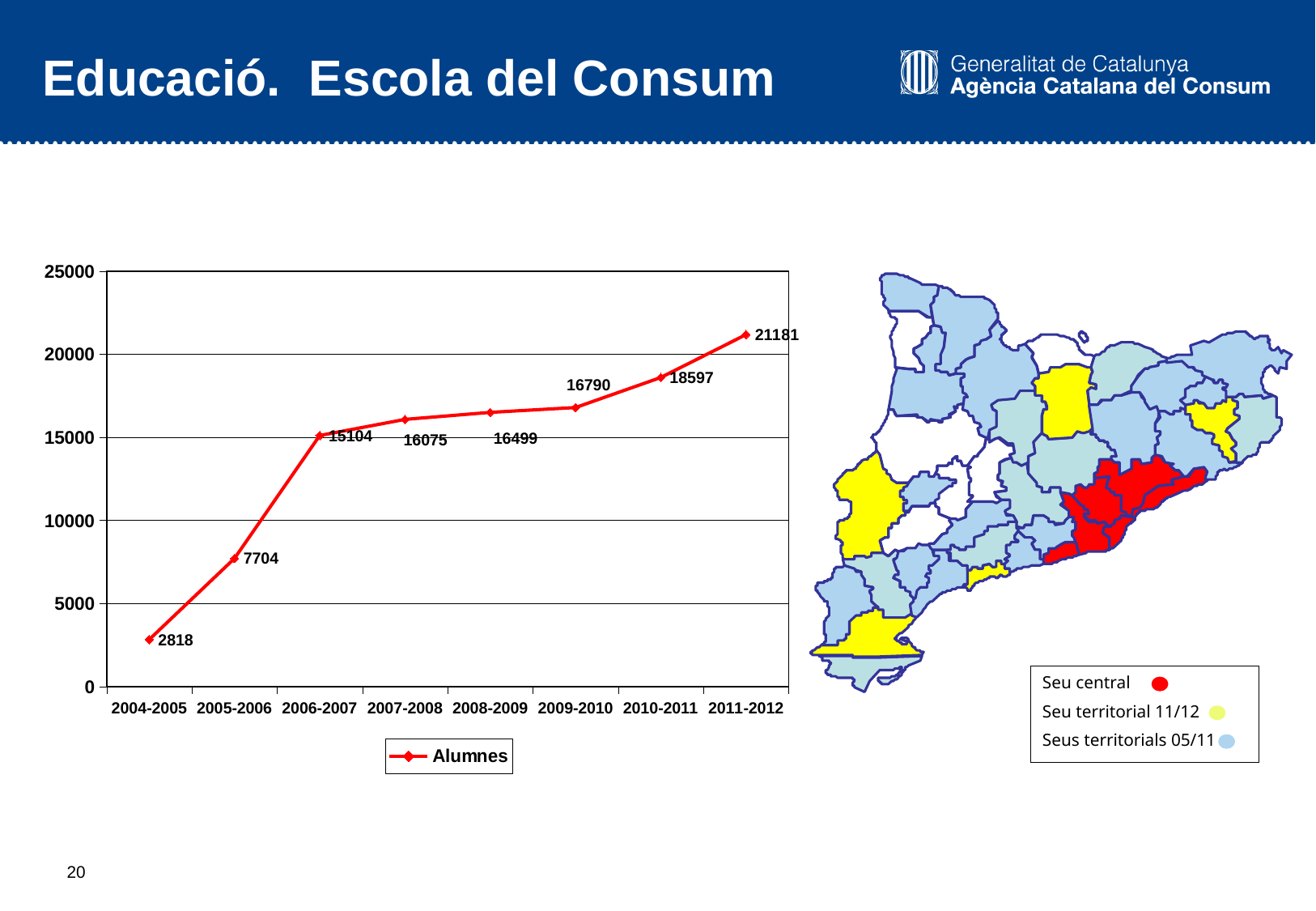
What is the value for Alumnes in 2011-2012? 21181 What is the difference in Alumnes between 2006-2007 and 2005-2006? 7400 Do the Alumnes values rise or fall from 2004-2005 to 2011-2012? rise What type of chart is shown on the left of the slide? line chart What is the difference in Alumnes between 2011-2012 and 2010-2011? 2584 What is the value for Alumnes in 2007-2008? 16075 Which school year has the lowest number of Alumnes? 2004-2005 Which year has more Alumnes, 2008-2009 or 2009-2010? 2009-2010 How many school years are plotted on the line chart? 8 Which school year has the highest number of Alumnes? 2011-2012 Is the value for Alumnes in 2010-2011 greater or less than 20000? less What is the value for Alumnes in 2004-2005? 2818